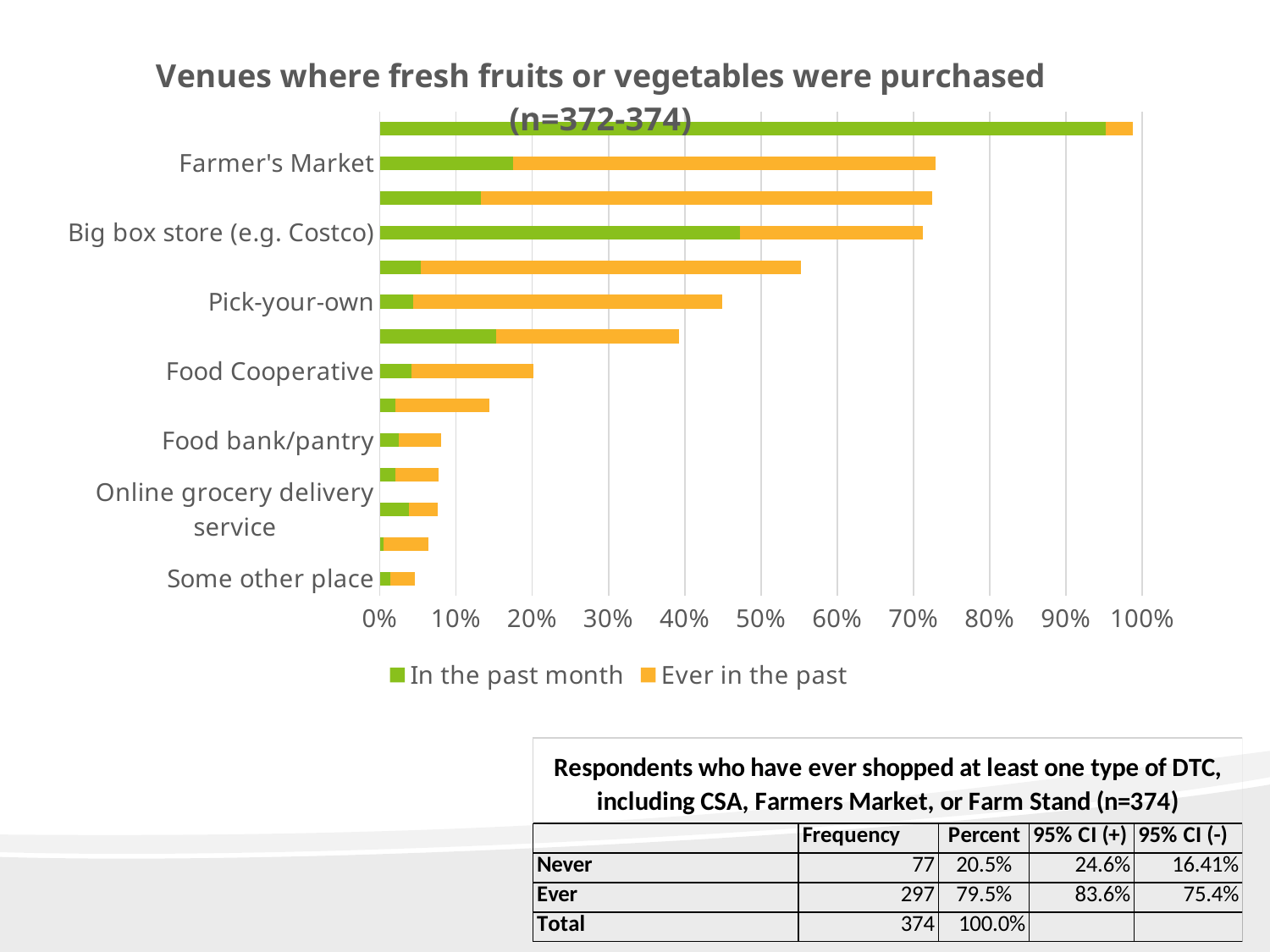
What kind of chart is shown on the slide? Bar chart What are the two series named in the chart legend? In the past month; Ever in the past Is the total bar length for Pick-your-own greater or less than 50%? less Which has the longer total bar, Farmer's Market or Pick-your-own? Farmer's Market Which category has the shortest bar in the chart? Some other place What is the title of the chart? Venues where fresh fruits or vegetables were purchased (n=372-374) Which has the larger 'In the past month' segment, Big box store (e.g. Costco) or Farmer's Market? Big box store (e.g. Costco) Is the total bar length for Food Cooperative greater or less than 30%? less Is the total bar length for Some other place greater or less than 10%? less How many series does the chart legend list? 2